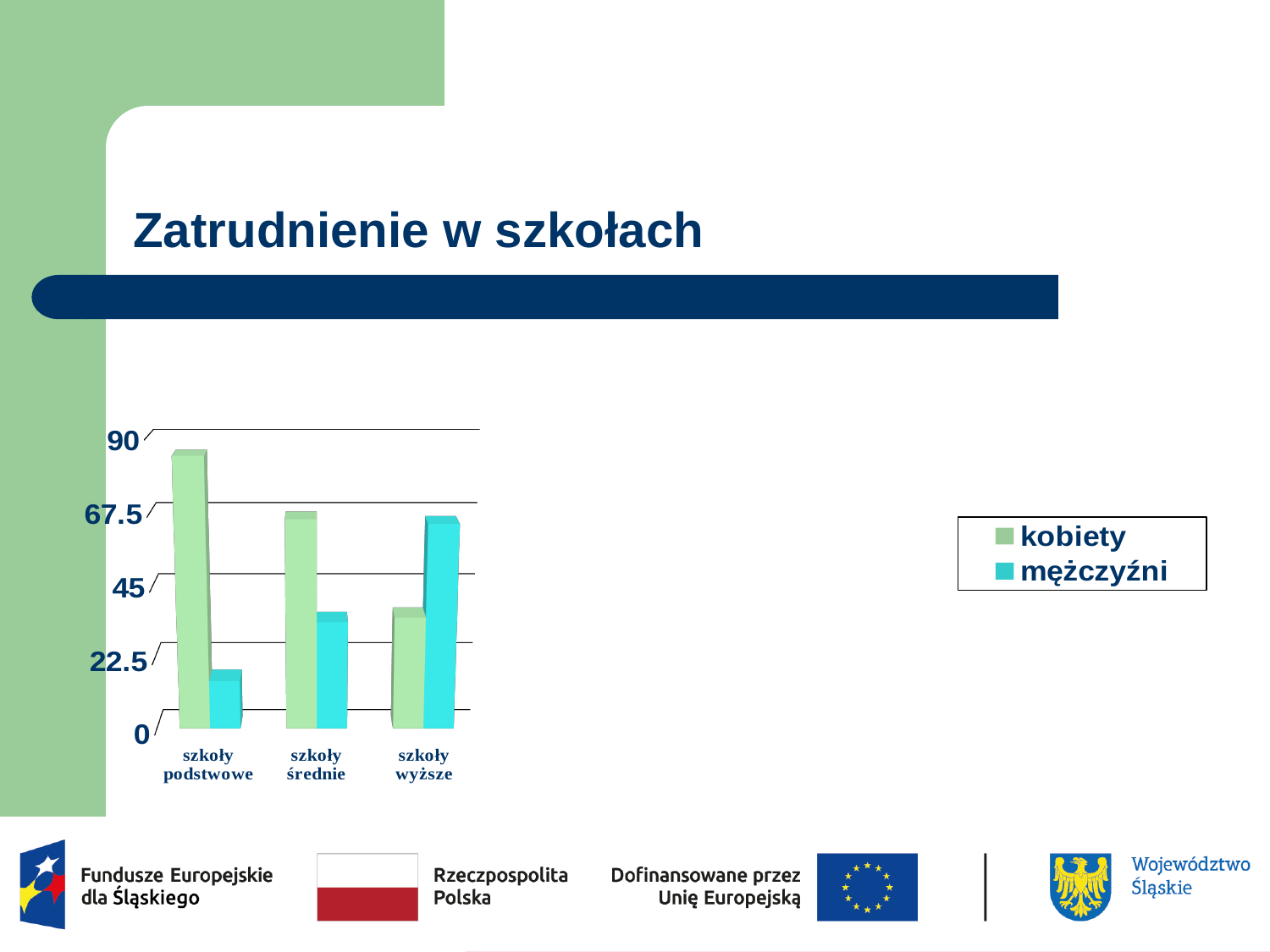
In szkoły wyższe, which series has the larger value, kobiety or mężczyźni? mężczyźni Which category has the lowest value for mężczyźni? szkoły podstwowe Which category has the highest value for mężczyźni? szkoły wyższe What is the title of the slide containing the chart? Zatrudnienie w szkołach Is the value for mężczyźni in szkoły średnie greater or less than 45? less Is the value for kobiety in szkoły podstwowe greater or less than 67.5? greater What kind of chart is shown on the slide? bar chart How many series does the legend list? 2 How many categories are shown on the x axis? 3 Which category has the highest value for kobiety? szkoły podstwowe Do the values for kobiety rise or fall from szkoły podstwowe to szkoły wyższe? fall Is the value for mężczyźni in szkoły podstwowe greater or less than 22.5? less